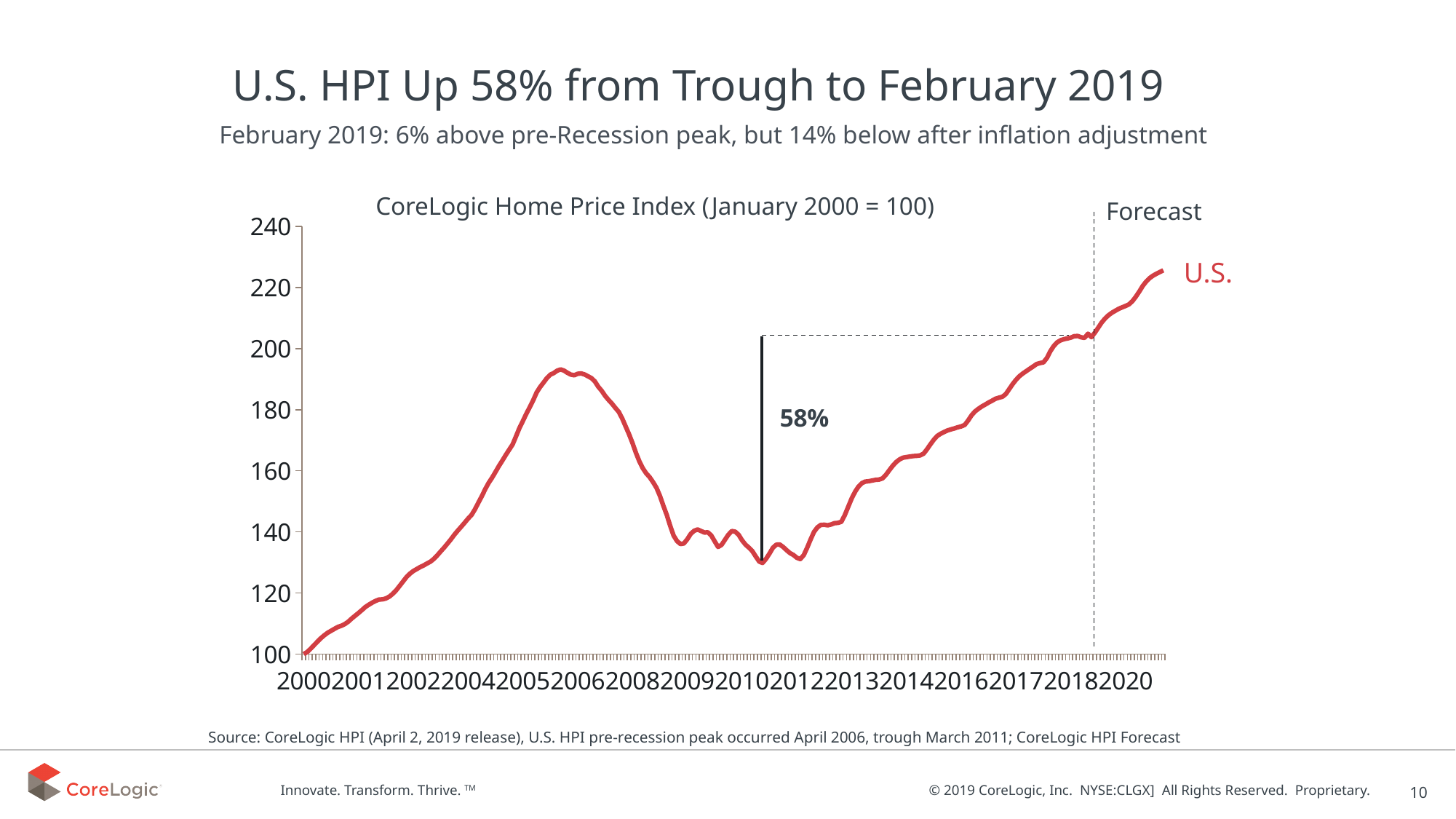
What is the value of the index at the start of the line in January 2000? 100 Does the index rise or fall between 2006 and 2009? fall What label is shown next to the end of the red line? U.S. What is the title of the chart? CoreLogic Home Price Index (January 2000 = 100) What kind of chart is shown on the slide? line chart In which year does the line reach its lowest value? 2000 Is the value of the index at its 2011 trough greater or less than 140? less What percentage increase from the trough is annotated on the chart? 58% Is the forecast value of the index at the end of the line in 2020 greater or less than 220? greater Is the value of the index in 2016 greater or less than 160? greater Does the index rise or fall between 2011 and 2018? rise